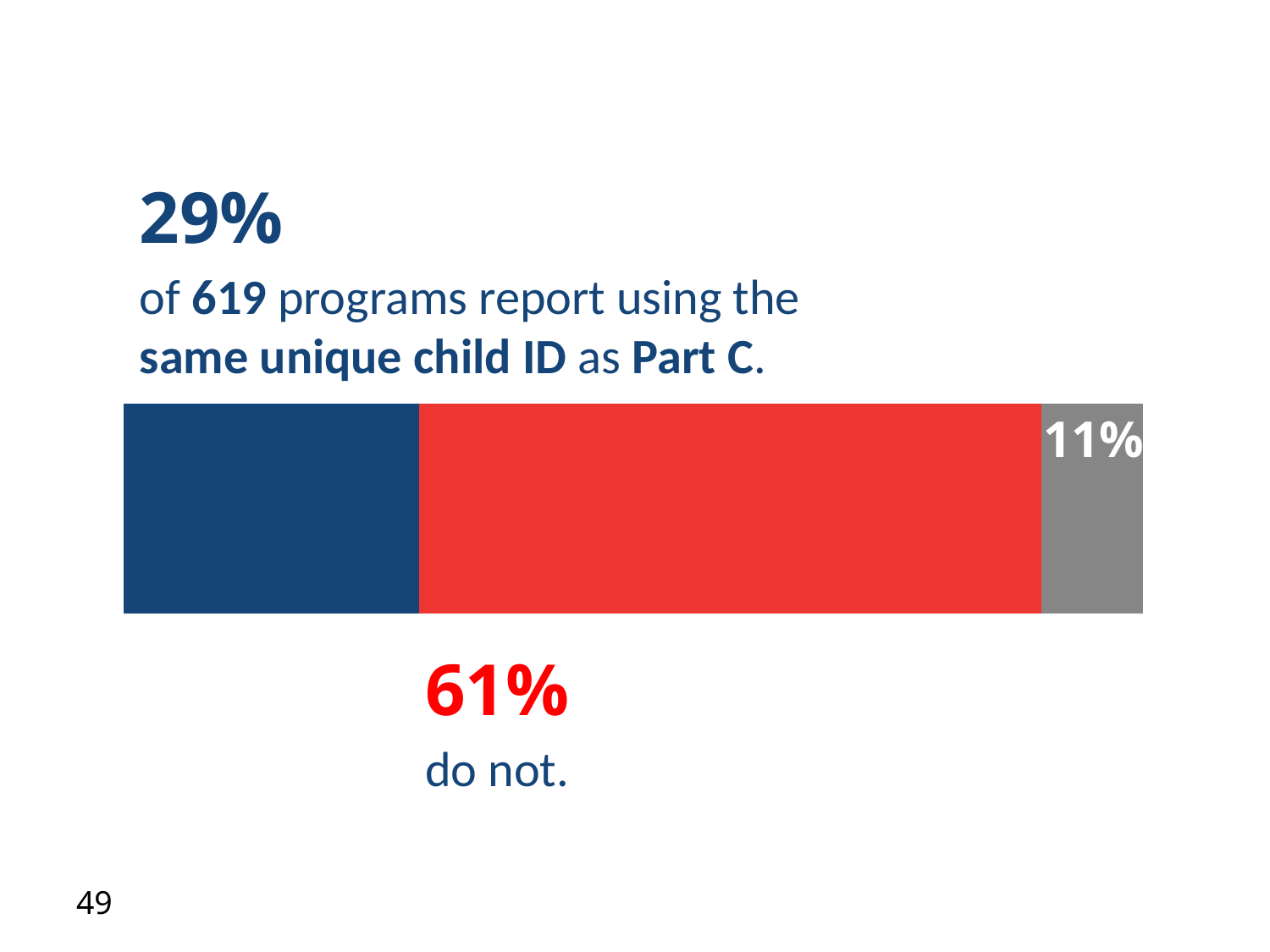
What value is printed on the gray segment of the bar? 11% What percentage of 619 programs do not use the same unique child ID as Part C? 61% What colour is the segment representing the 29% of programs that use the same unique child ID as Part C? Blue Which is larger: the share of programs using the same unique child ID as Part C, or the share that do not? The share that do not (61%) What is the difference in percentage points between the blue segment (29%) and the gray segment (11%)? 18 percentage points What percentage of 619 programs report using the same unique child ID as Part C? 29% How many segments does the stacked bar have? 3 Which segment of the bar is the largest? The red segment (61%, do not) What colour is the segment representing the 61% of programs that do not use the same unique child ID? Red What is the difference in percentage points between programs that do not use the same unique child ID (61%) and those that do (29%)? 32 percentage points What kind of chart is shown on the slide? A stacked bar chart Which segment of the bar is the smallest? The gray segment (11%)